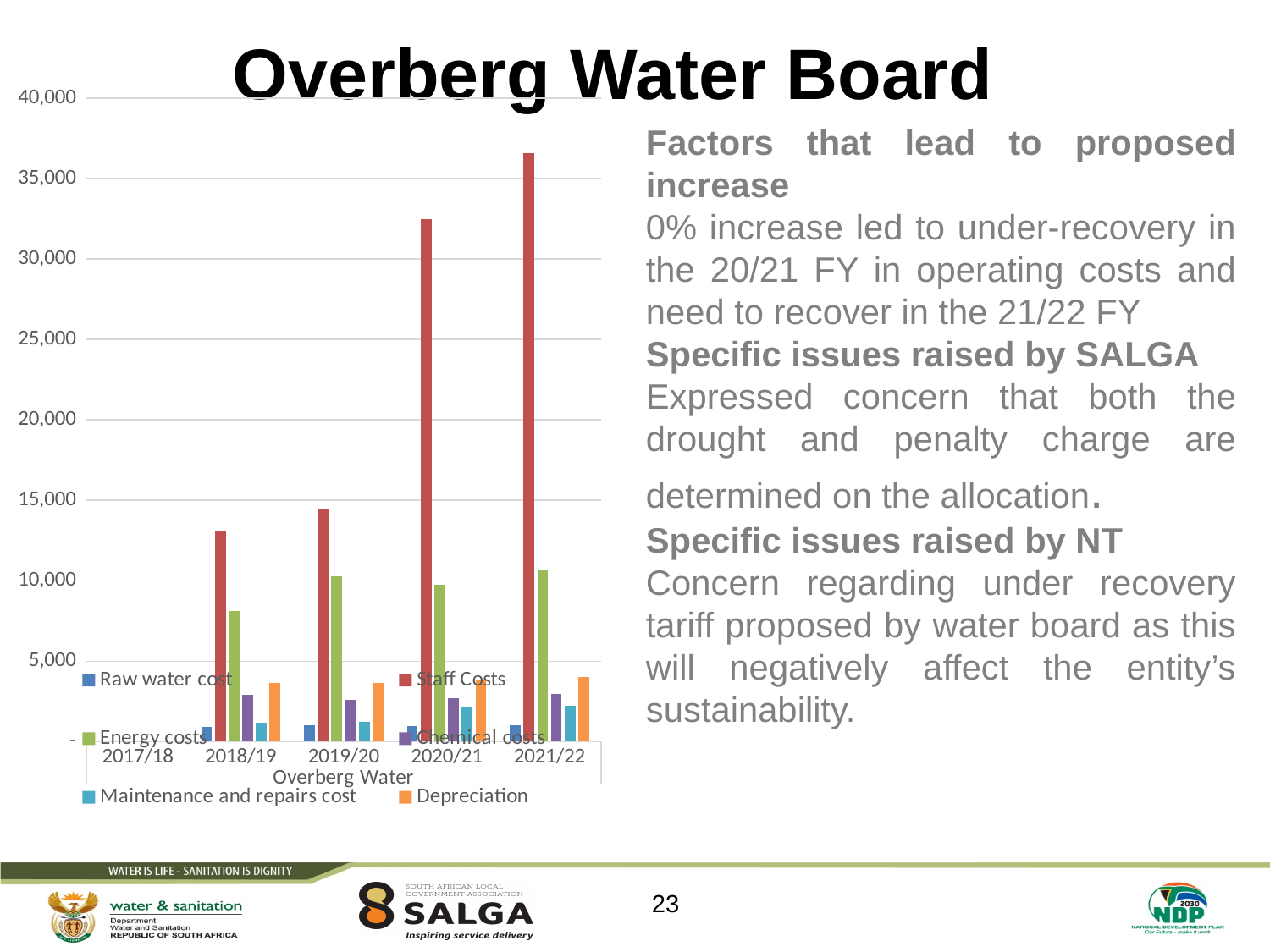
What kind of chart is shown on the slide? bar chart Do the Staff Costs bars rise or fall from 2018/19 to 2021/22? rise Which year has the highest Staff Costs bar? 2021/22 Is the Staff Costs value for 2019/20 greater or less than 15,000? less What label appears under the x axis of the chart? Overberg Water Which series has the tallest bar in 2020/21? Staff Costs Is the Staff Costs value for 2020/21 greater or less than 30,000? greater Which is larger, Staff Costs in 2019/20 or Staff Costs in 2020/21? 2020/21 Is the Energy costs value for 2018/19 greater or less than 10,000? less How many series does the chart legend list? 6 How many year categories are shown on the x axis of the chart? 5